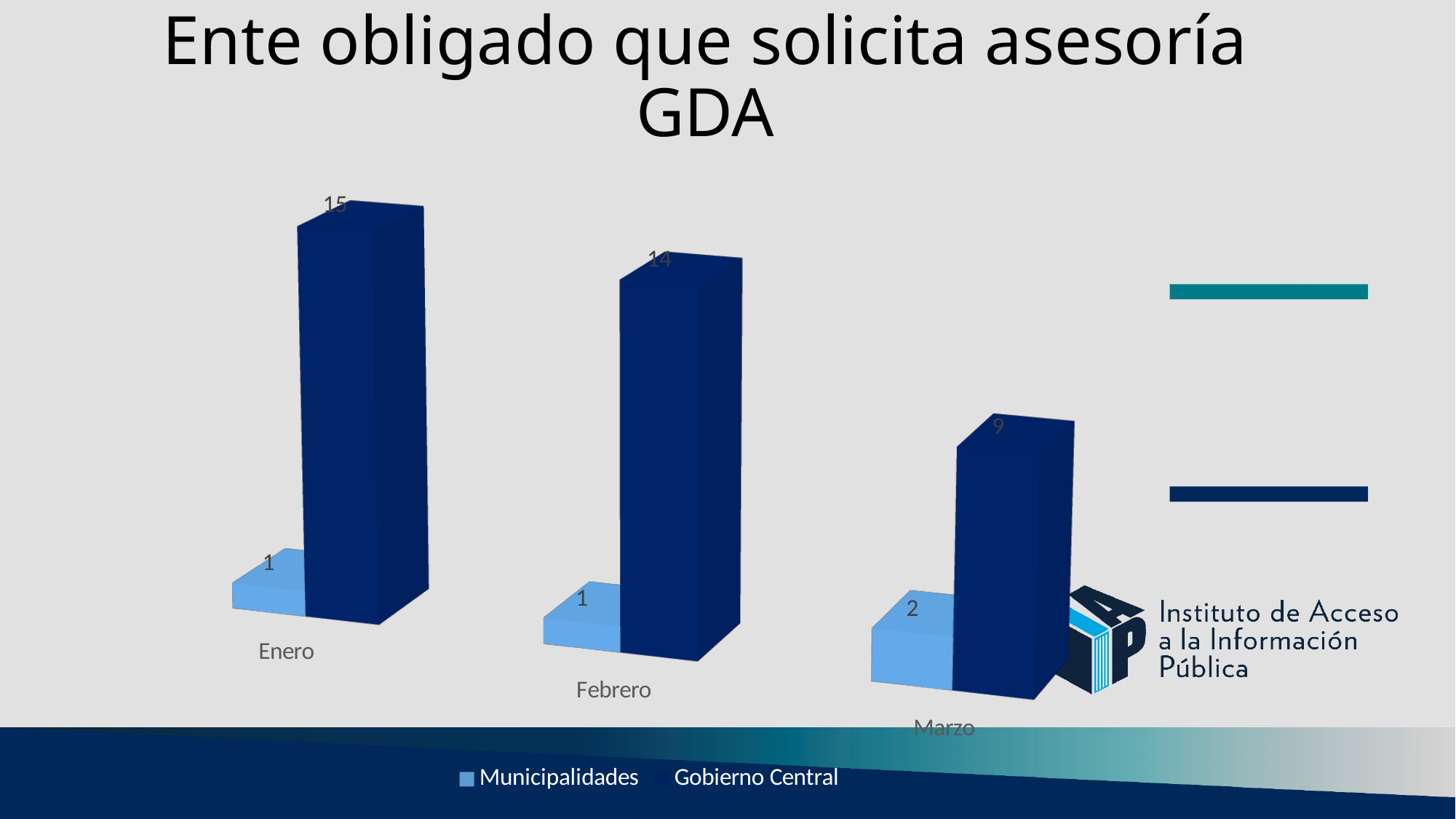
What is the value for Municipalidades in Marzo? 2 Which is larger in Marzo, Municipalidades or Gobierno Central? Gobierno Central In which month is the Gobierno Central value lowest? Marzo How many series does the legend list? 2 In which month is the Gobierno Central value highest? Enero What is the difference between the Gobierno Central values for Enero and Marzo? 6 What kind of chart is shown on the slide? Bar chart What is the value for Municipalidades in Enero? 1 What is the value for Gobierno Central in Febrero? 14 How many months are shown on the x axis? 3 Does the Gobierno Central value rise or fall from Enero to Marzo? Fall What is the value for Gobierno Central in Enero? 15